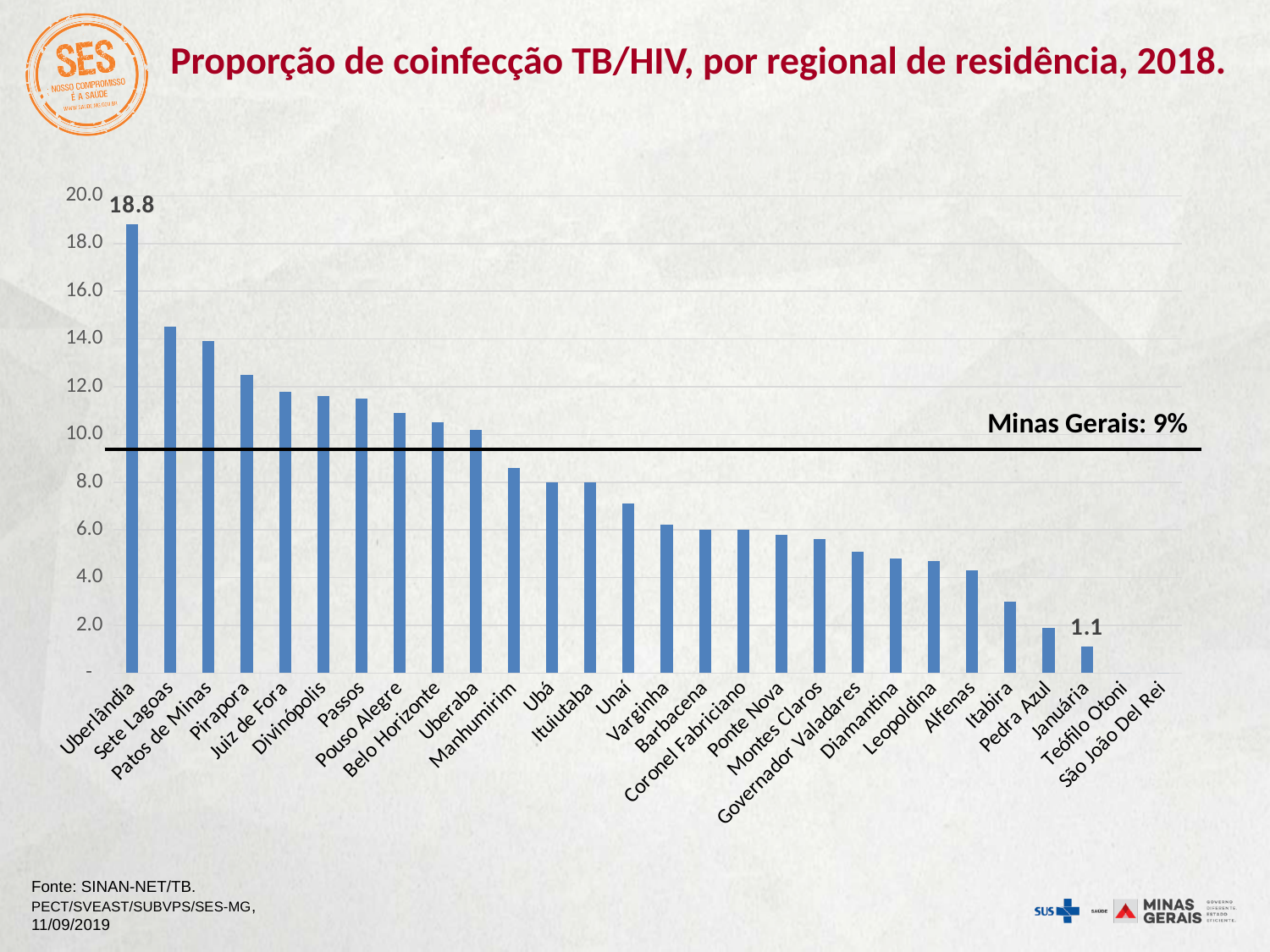
Which is larger, the value for Pirapora or the value for Juiz de Fora? Pirapora What value does the horizontal reference line labelled for Minas Gerais represent? 9% Which is larger, the value for Belo Horizonte or the value for Manhumirim? Belo Horizonte What kind of chart is shown on the slide? Bar chart Is the value for Itabira greater or less than 4.0? less Is the value for Unaí greater or less than 8.0? less What is the value for Uberlândia? 18.8 Is the value for Pirapora greater or less than 12.0? greater Which regional has the highest proportion of TB/HIV coinfection? Uberlândia Do the values rise or fall moving from left to right along the x axis? Fall